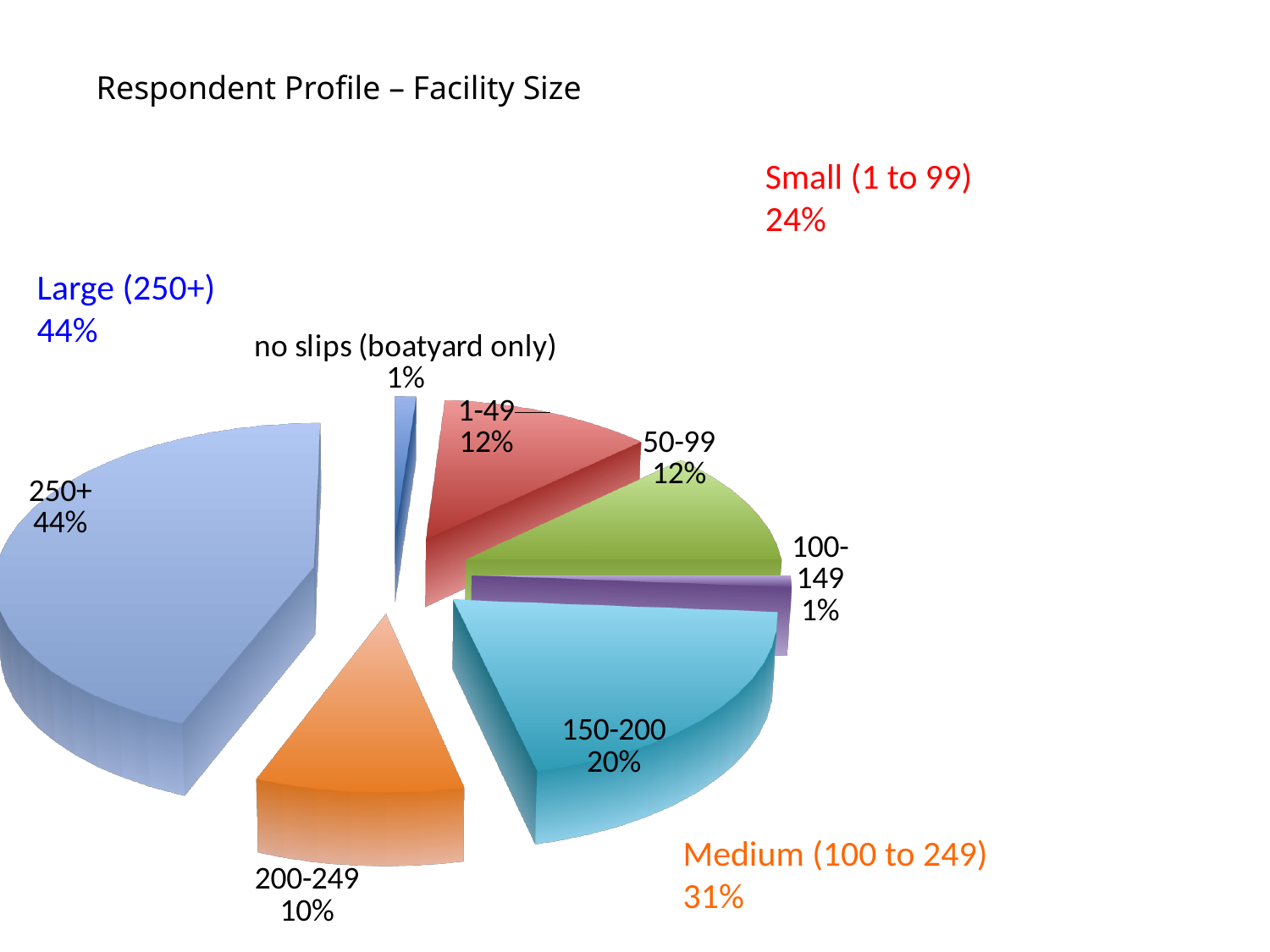
What percentage is given for the Medium (100 to 249) group in the annotation? 31% What kind of chart is shown on the slide? pie chart What is the difference in percentage points between the 150-200 slice and the 200-249 slice? 10 What percentage is given for the Small (1 to 99) group in the annotation? 24% What share of respondents have no slips (boatyard only)? 1% Which is larger, the share for 1-49 or the share for 150-200? 150-200 What share of respondents have 150-200 slips? 20% What share of respondents have 200-249 slips? 10% What share of respondents have 250+ slips? 44% How many slices does the pie chart have? 7 Which facility size category has the largest share of the pie? 250+ What is the title of the slide? Respondent Profile – Facility Size